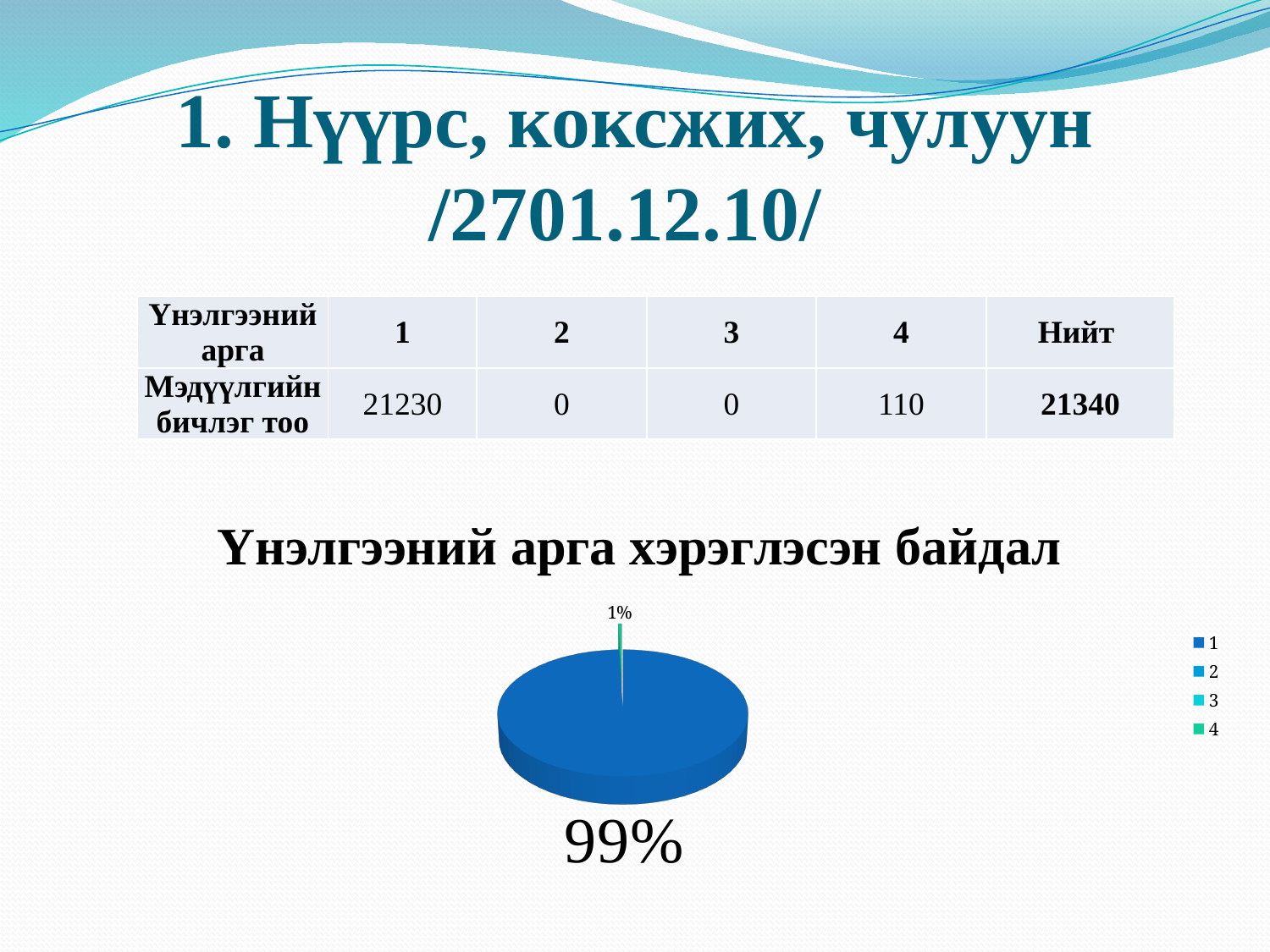
What kind of chart is shown on the slide? pie chart Which is larger, the slice for category 1 or the slice for category 4? 1 How many entries does the chart's legend list? 4 What is the title of the chart? Үнэлгээний арга хэрэглэсэн байдал Which category has the largest slice of the pie? 1 What colour is the largest slice of the pie? blue What share of the pie does category 4 take? 1% What is the difference in percentage points between the slice for category 1 and the slice for category 4? 98 What share of the pie does category 1 take? 99% Is the share for category 1 greater or less than 50%? greater